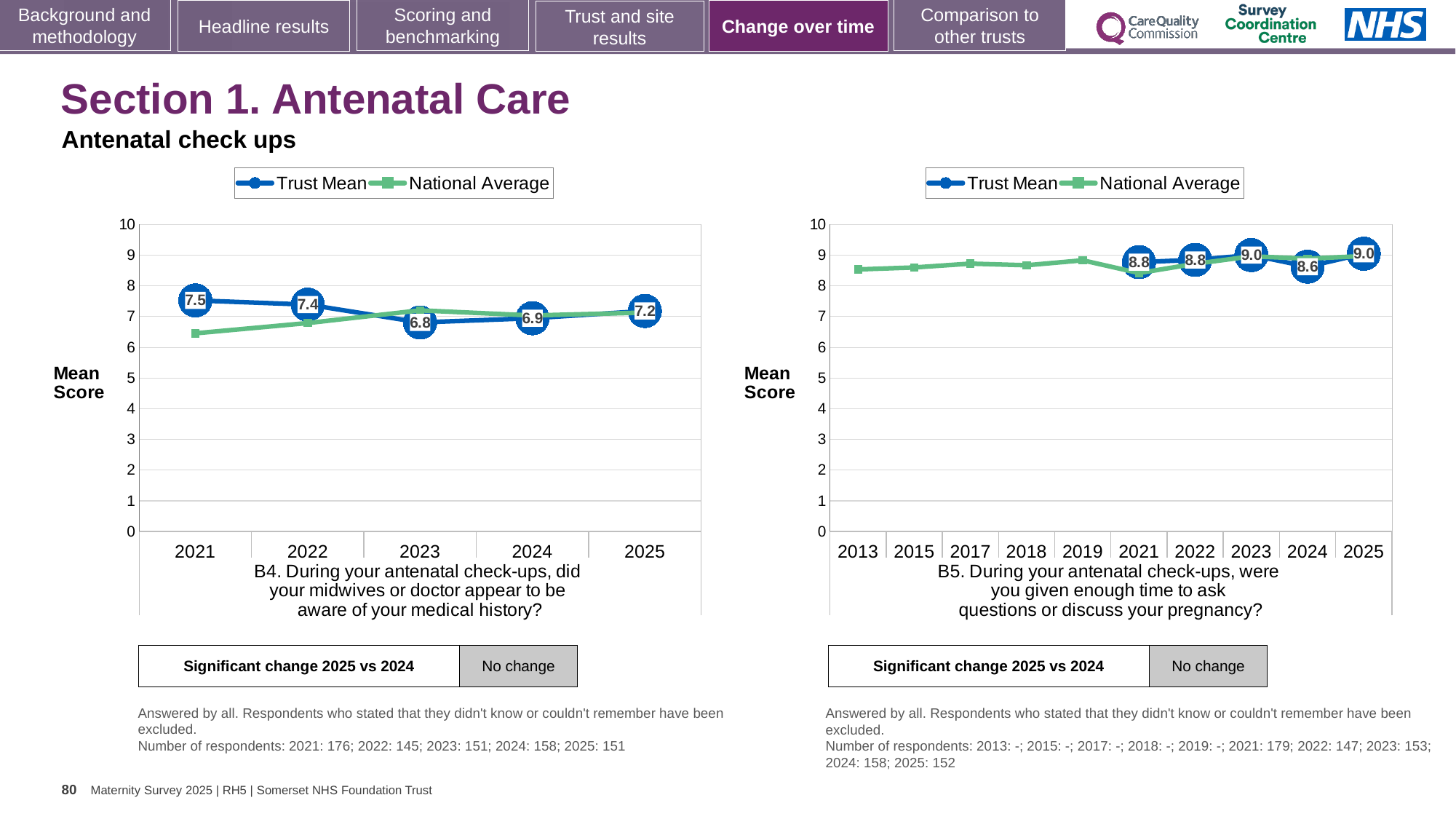
In the right chart (B5), is the Trust Mean for 2023 larger or smaller than the Trust Mean for 2024? larger In the right chart (B5), which year has the lowest Trust Mean? 2024 In the left chart (B4), what is the Trust Mean for 2025? 7.2 In the left chart (B4), what is the difference between the Trust Mean in 2021 and in 2023? 0.7 In the left chart (B4), what is the Trust Mean for 2021? 7.5 In the left chart (B4), which year has the lowest Trust Mean? 2023 In the right chart (B5), what is the Trust Mean for 2024? 8.6 What type of chart is the left chart (B4)? Line chart How many series does the legend of the right chart (B5) list? 2 In the right chart (B5), how many years are shown on the x axis? 10 In the left chart (B4), is the National Average for 2021 greater or less than 7? less In the left chart (B4), how many years are shown on the x axis? 5